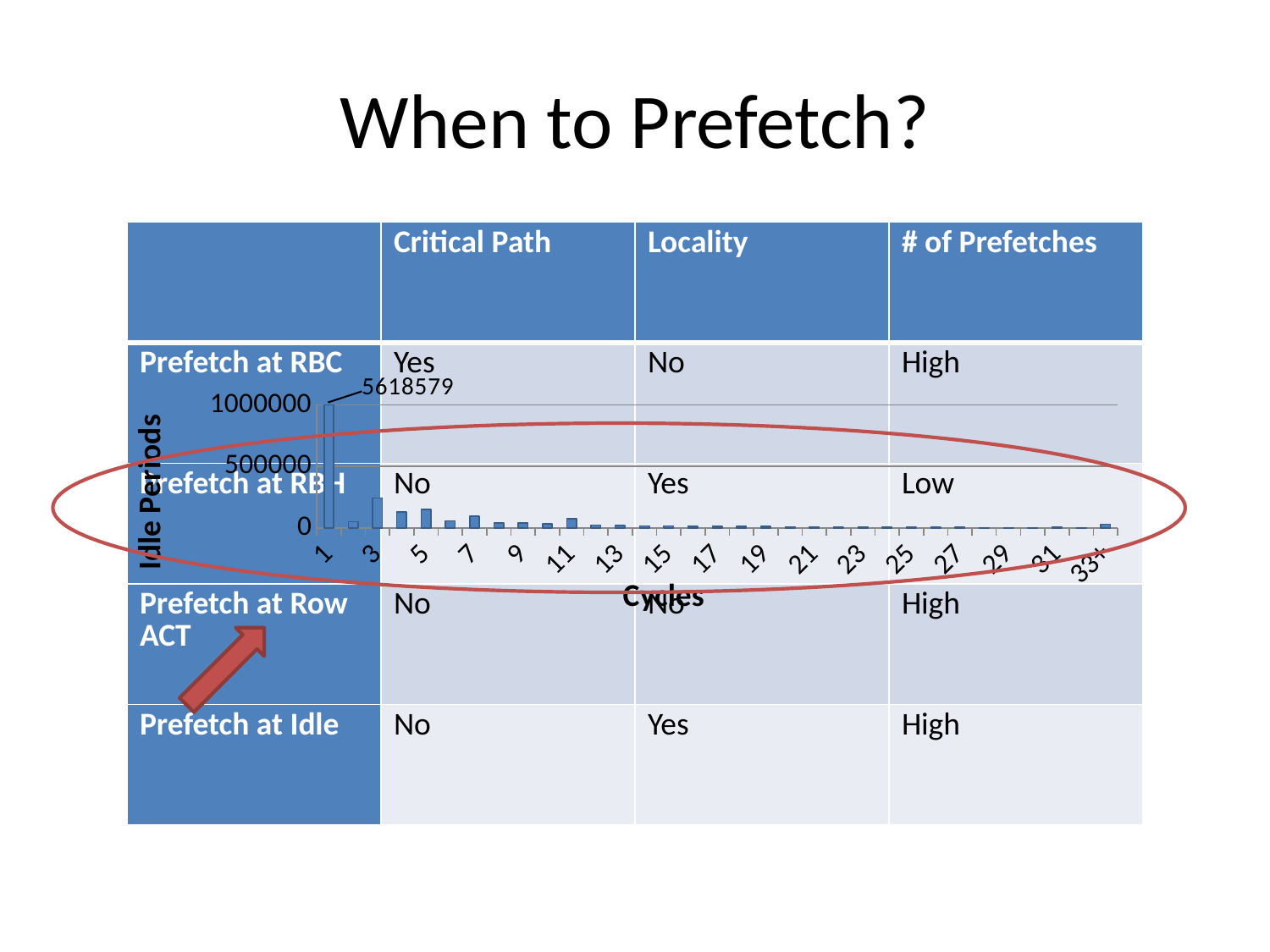
Do the Idle Periods values generally rise or fall as Cycles increase along the x axis? fall Is the value for cycle 1 greater or less than 1000000? greater What is the title of the x axis of the chart? Cycles What is the value of Idle Periods for cycle 1? 5618579 Which has more Idle Periods, cycle 1 or cycle 5? cycle 1 Which cycle has the highest number of Idle Periods? 1 Is the value for cycle 15 greater or less than 500000? less What is the title of the y axis of the chart? Idle Periods Is the value for cycle 3 greater or less than 500000? less What kind of chart is shown on the slide? bar chart